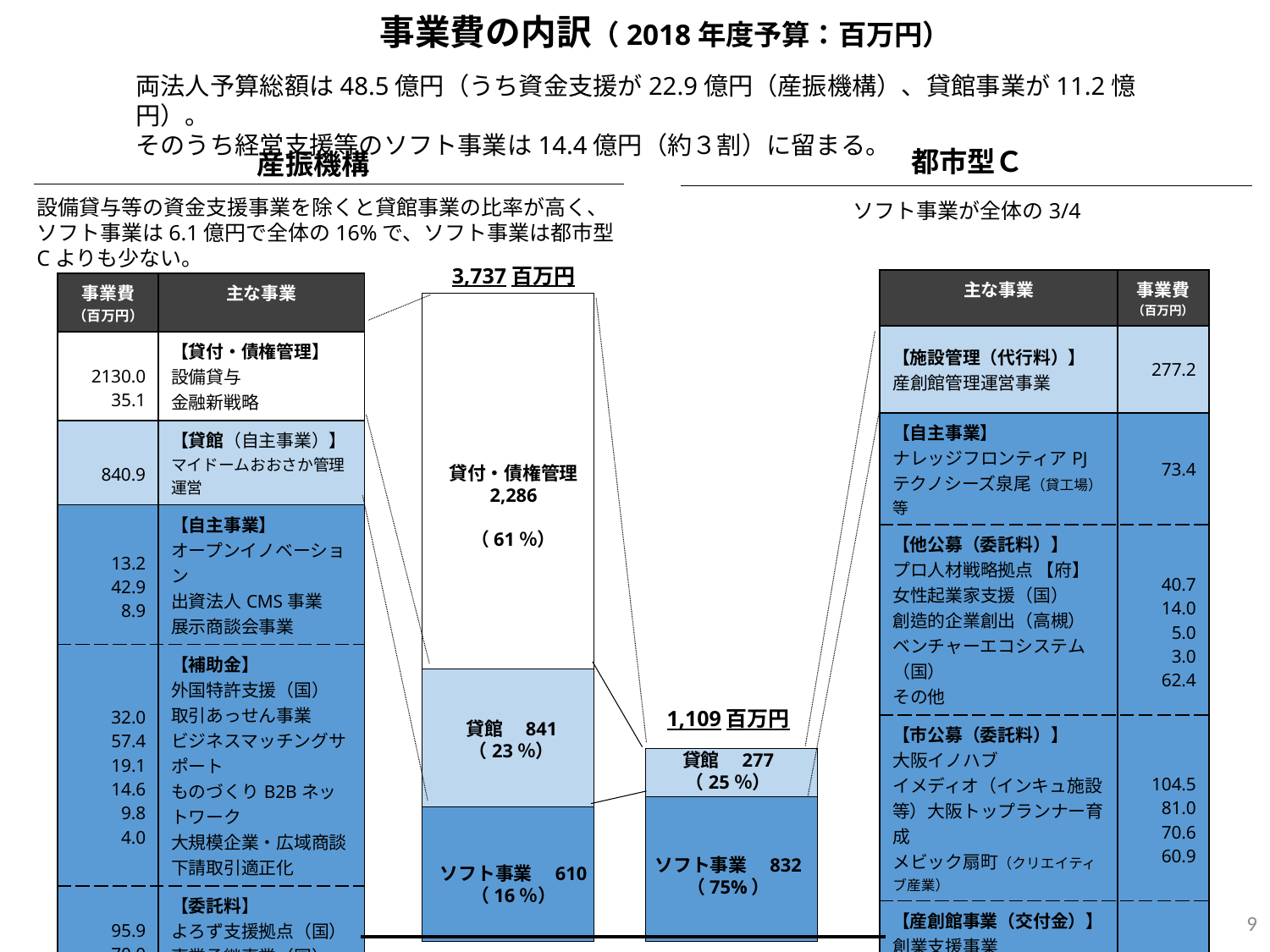
In the 産振機構 stacked bar, what is the value for 貸付・債権管理? 2,286 In the 産振機構 stacked bar, which segment is the smallest? ソフト事業 What percentage share does ソフト事業 have in the 都市型C stacked bar? 75% In the 都市型C stacked bar, what is the value for 貸館? 277 Which is larger: ソフト事業 in the 産振機構 bar or ソフト事業 in the 都市型C bar? 都市型C In the 産振機構 stacked bar, what is the value for ソフト事業? 610 What is the total of the 産振機構 stacked bar? 3,737 百万円 In the 産振機構 stacked bar, which segment is the largest? 貸付・債権管理 What is the total of the 都市型C stacked bar? 1,109 百万円 In the 都市型C stacked bar, what is the value for ソフト事業? 832 In the 都市型C stacked bar, what is the difference between ソフト事業 and 貸館? 555 In the 産振機構 stacked bar, what is the difference between 貸館 and ソフト事業? 231